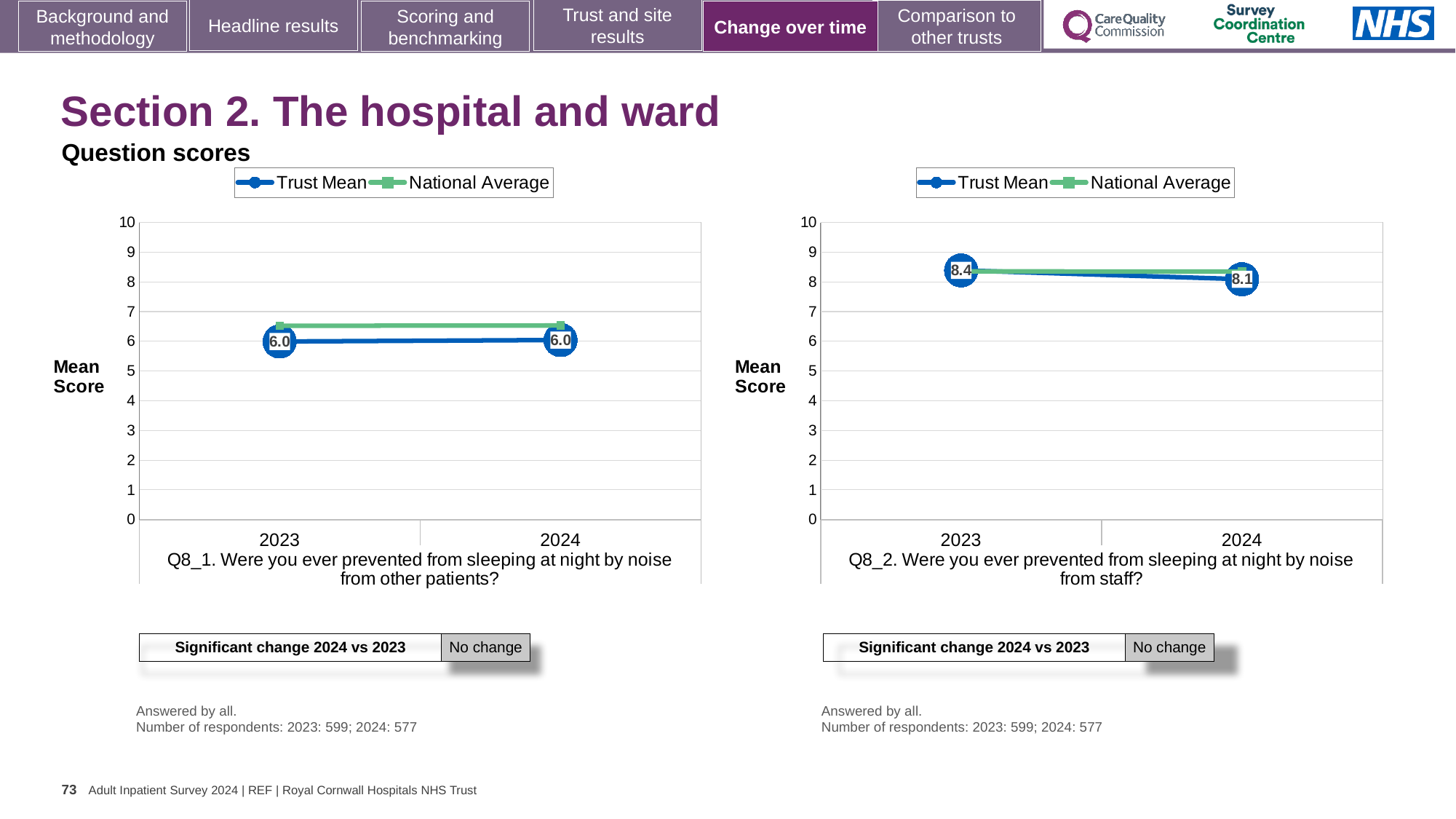
In the Q8_2 chart (right), which year has the higher Trust Mean score, 2023 or 2024? 2023 In the Q8_2 chart (right), by how much did the Trust Mean score change from 2023 to 2024? 0.3 In the Q8_1 chart (left), what is the Trust Mean score for 2024? 6.0 What kind of chart is the Q8_1 chart (left)? line chart In the Q8_1 chart (left), what is the Trust Mean score for 2023? 6.0 How many series does the legend of the Q8_2 chart (right) list? 2 In the Q8_2 chart (right), does the Trust Mean rise or fall from 2023 to 2024? fall In the Q8_2 chart (right), what is the Trust Mean score for 2024? 8.1 In the Q8_1 chart (left), which series is higher in 2023, Trust Mean or National Average? National Average In the Q8_1 chart (left), is the National Average for 2024 greater or less than 7? less In the Q8_1 chart (left), does the Trust Mean rise, fall or stay the same from 2023 to 2024? stay the same In the Q8_2 chart (right), what is the Trust Mean score for 2023? 8.4